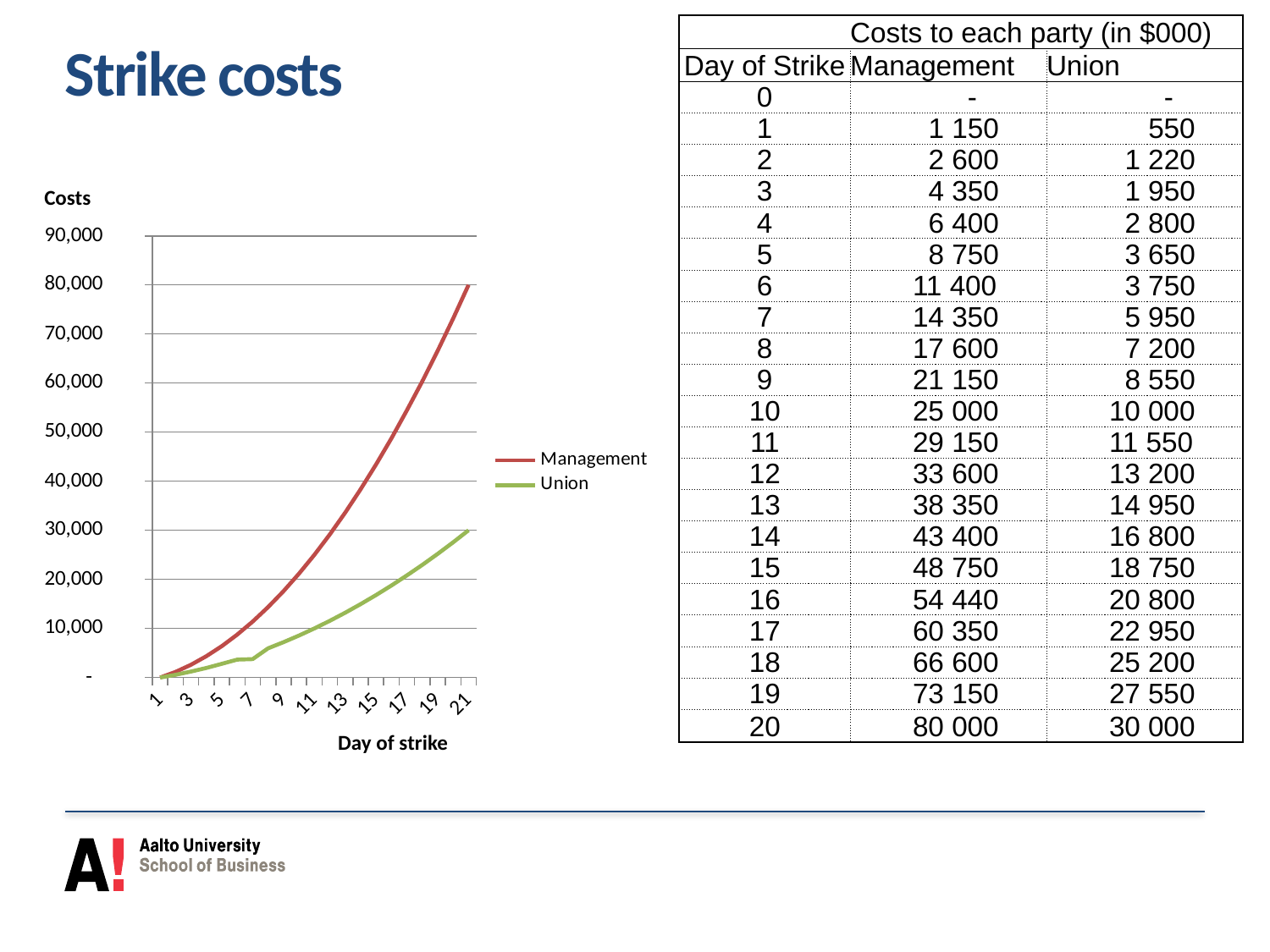
What is the title of the chart's horizontal axis? Day of strike Is the final value of the Union line greater or less than 40,000? less Do the costs in the chart rise or fall as the day of strike increases? rise According to the table, what is the Management cost on day 5 of the strike? 8 750 Which series reaches the higher value at the end of the chart, Management or Union? Management What are the two series named in the chart's legend? Management and Union Is the final value of the Management line greater or less than 70,000? greater According to the table, what is the Management cost on day 10 of the strike? 25 000 According to the table, how much higher is the Management cost than the Union cost on day 20? 50 000 How many series does the chart's legend list? 2 According to the table, what is the Union cost on day 20 of the strike? 30 000 What kind of chart is shown on the slide? line chart